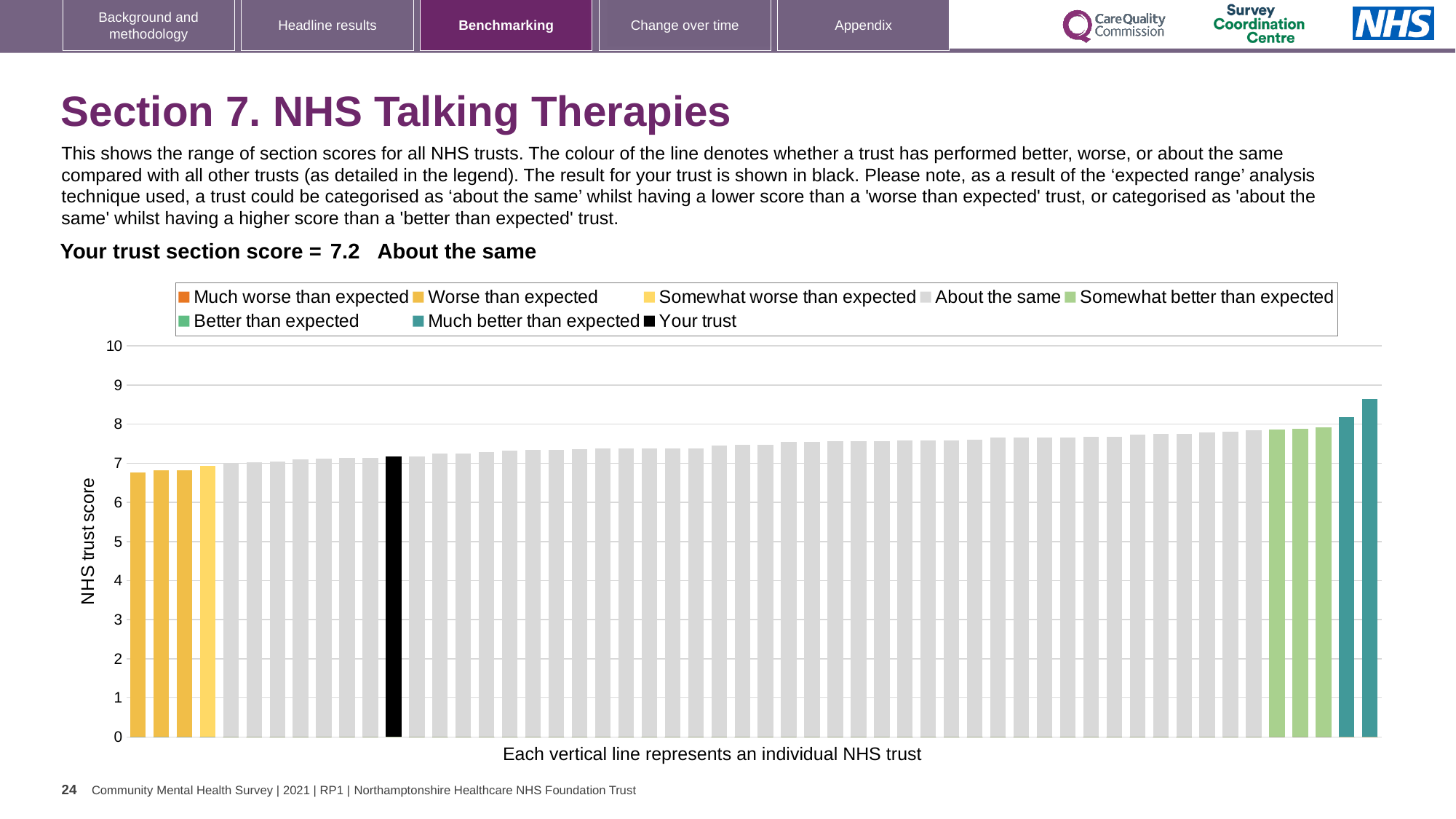
Which category is your trust's section score placed in? About the same What is the label on the vertical axis of the chart? NHS trust score Which legend category does the tallest bar belong to? Much better than expected What kind of chart is shown on the slide? Bar chart How many entries does the chart legend list? 8 Is the value of the shortest bar greater or less than 7? less Is the value of the tallest bar greater or less than 8? greater What is the section score for your trust shown on the slide? 7.2 How many bars are coloured as 'Much better than expected' (teal)? 2 Is the value of the black bar (your trust) greater or less than 5? greater Do the bar values rise or fall from left to right along the x axis? Rise